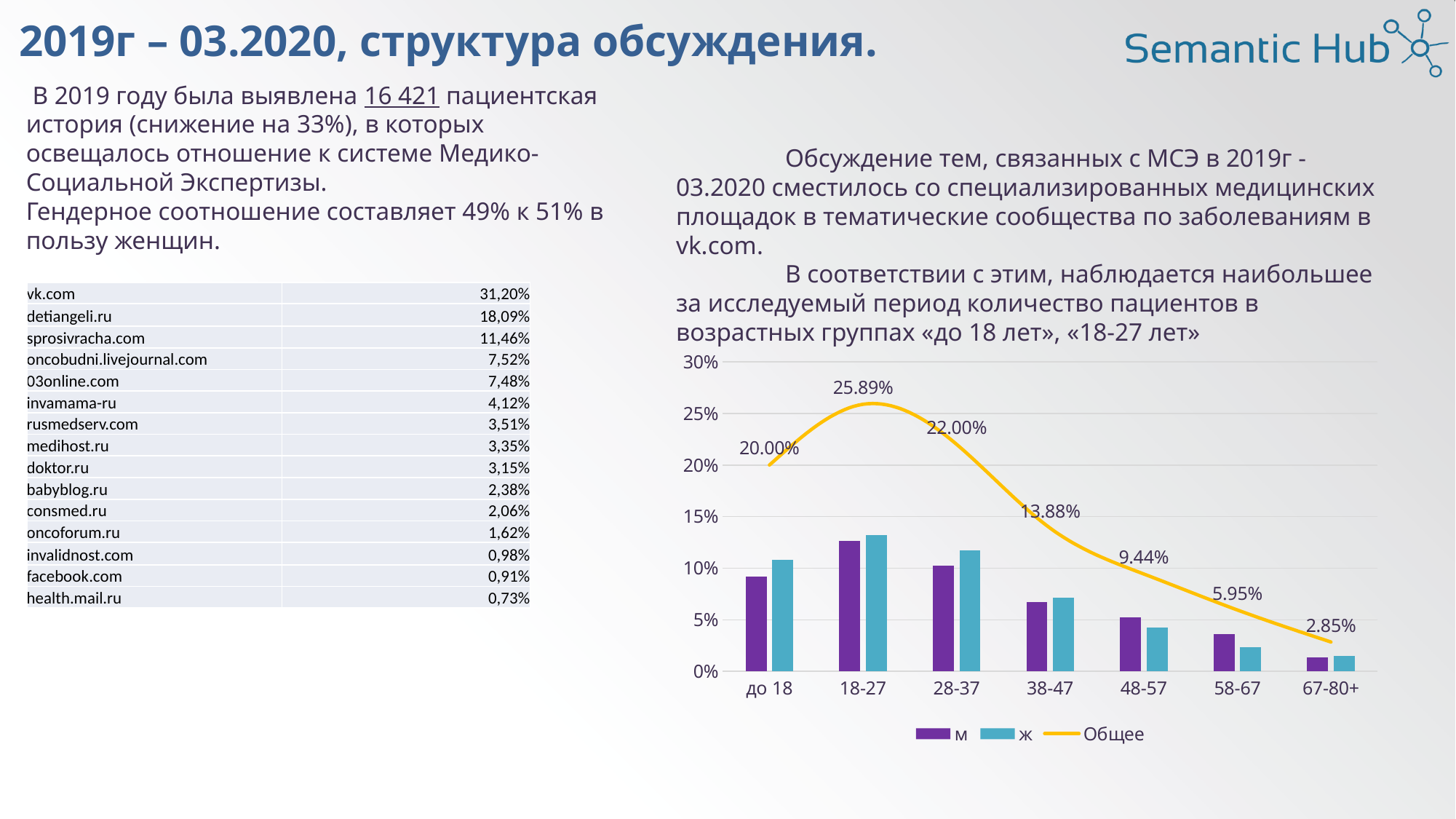
What is the difference between the Общее values for 18-27 and 28-37? 3.89% What is the value of the Общее line for the 18-27 age group? 25.89% How many series does the chart legend list? 3 For the до 18 age group, which bar is taller, м or ж? ж What is the value of the Общее line for the 38-47 age group? 13.88% Does the Общее line rise or fall from the 18-27 age group to the 67-80+ age group? fall Which age group has the highest value on the Общее line? 18-27 Is the ж bar for the 48-57 age group greater or less than 5%? less Is the м bar for the до 18 age group greater or less than 10%? less How many age groups are shown on the x axis of the chart? 7 Which age group has the lowest value on the Общее line? 67-80+ What is the value of the Общее line for the 67-80+ age group? 2.85%